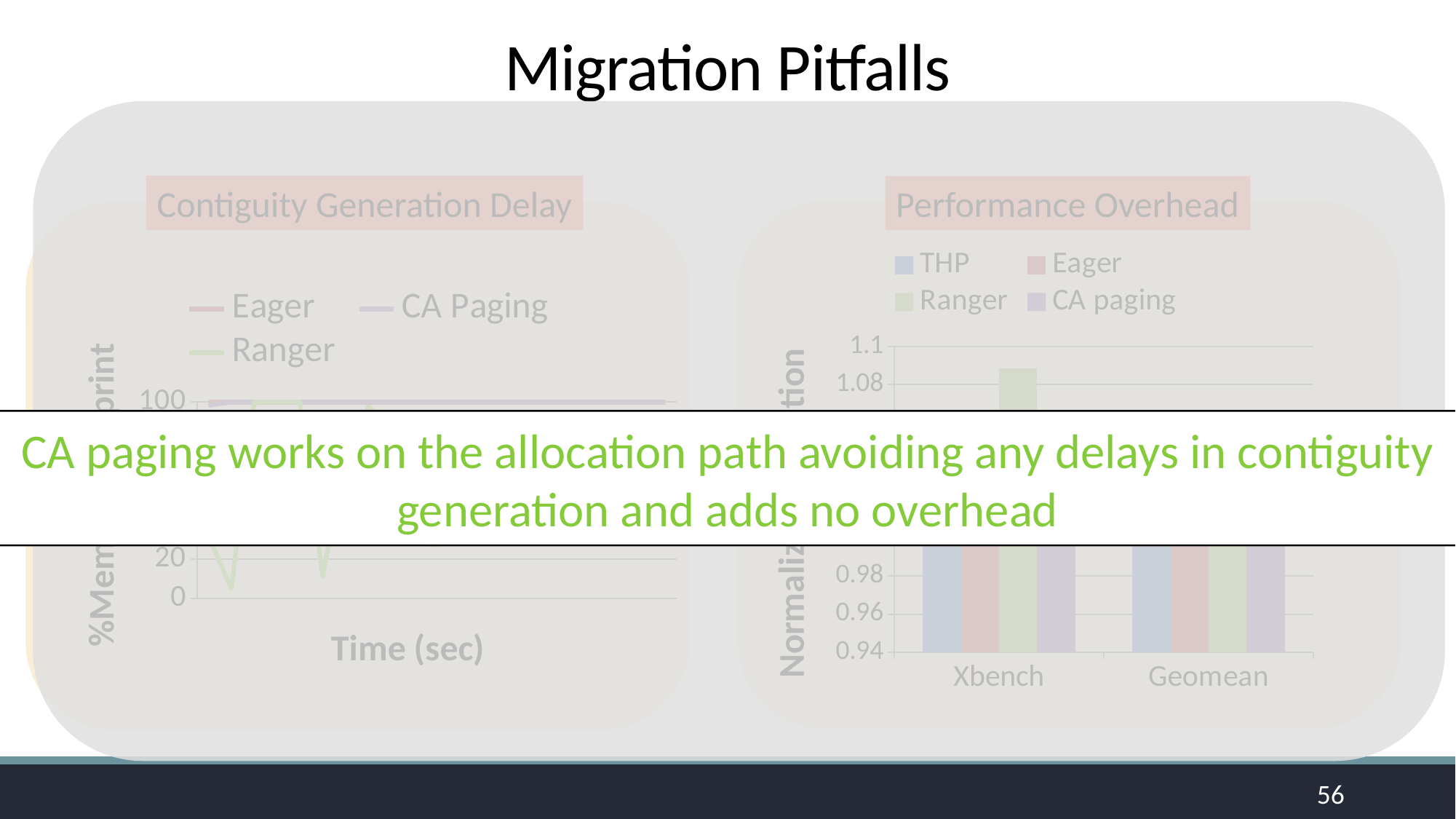
How many series does the legend of the Performance Overhead chart list? 4 In the Performance Overhead chart, which series has the highest value for Xbench? Ranger What is the x-axis title of the Contiguity Generation Delay chart? Time (sec) What kind of chart is the Performance Overhead chart on the right? bar chart In the Performance Overhead chart, is the Ranger value for Xbench greater or less than 1.08? greater What kind of chart is the Contiguity Generation Delay chart on the left? line chart What are the two category labels on the x axis of the Performance Overhead chart? Xbench, Geomean How many categories are shown on the x axis of the Performance Overhead chart? 2 Which series are listed in the legend of the Contiguity Generation Delay chart? Eager, CA Paging, Ranger How many series does the legend of the Contiguity Generation Delay chart list? 3